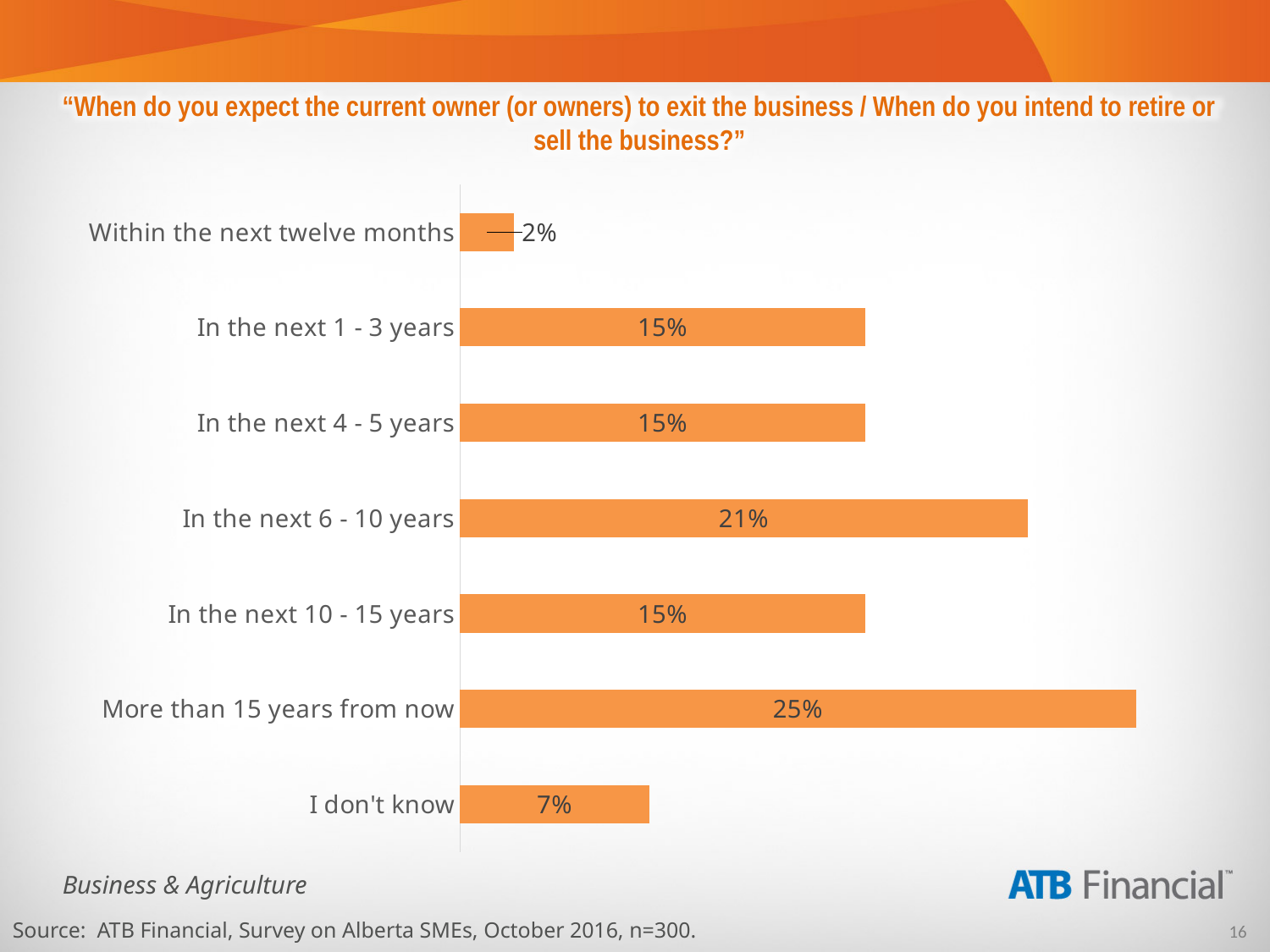
What is the value for "More than 15 years from now"? 25% How many categories share the value 15%? 3 How many categories are shown in the chart? 7 Which is larger, the value for "I don't know" or the value for "In the next 4 - 5 years"? In the next 4 - 5 years What is the difference between the values for "More than 15 years from now" and "In the next 6 - 10 years"? 4% Which category has the lowest value? Within the next twelve months What is the difference between the values for "In the next 6 - 10 years" and "In the next 1 - 3 years"? 6% What percentage of respondents answered "I don't know"? 7% What kind of chart is shown on the slide? Bar chart What is the value for "In the next 6 - 10 years"? 21% Which category has the highest value? More than 15 years from now What percentage of respondents expect the owner to exit the business within the next twelve months? 2%